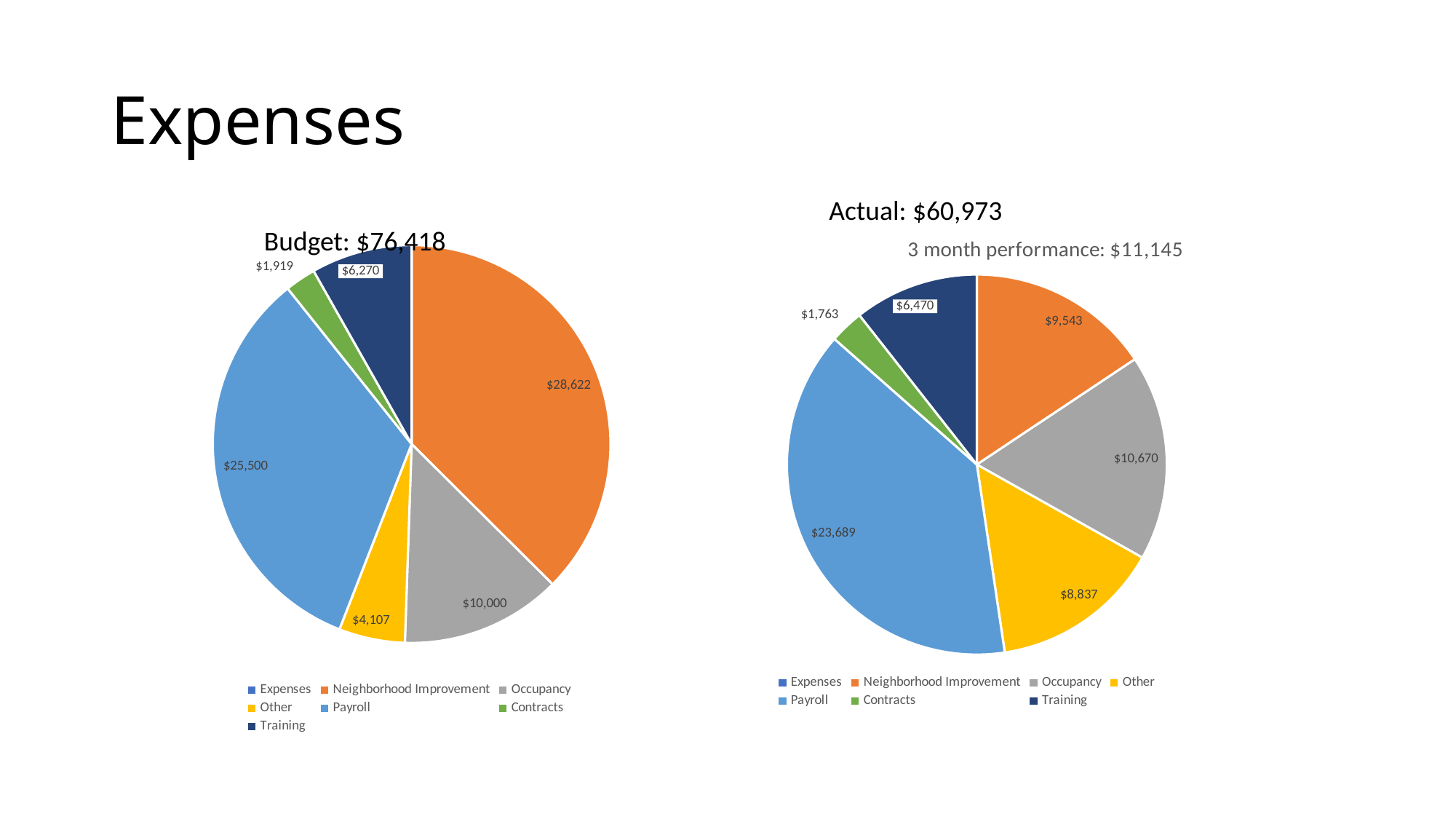
In the Actual chart, what is the value of the Contracts slice? $1,763 In the Actual chart, what is the value of the Occupancy slice? $10,670 In the Budget chart, what is the value of the Neighborhood Improvement slice? $28,622 In the Budget chart, what is the value of the Payroll slice? $25,500 What type of charts are shown on the slide? Pie charts In the Actual chart, which is larger: Occupancy or Neighborhood Improvement? Occupancy In the Actual chart, which category has the largest slice? Payroll In the Budget chart, which category has the largest slice? Neighborhood Improvement What total is shown in the title of the Budget chart? $76,418 In the Budget chart, what is the difference between the Neighborhood Improvement and Payroll values? $3,122 What is the difference between the Training value in the Actual chart and the Training value in the Budget chart? $200 In the Actual chart, which category has the smallest slice? Contracts